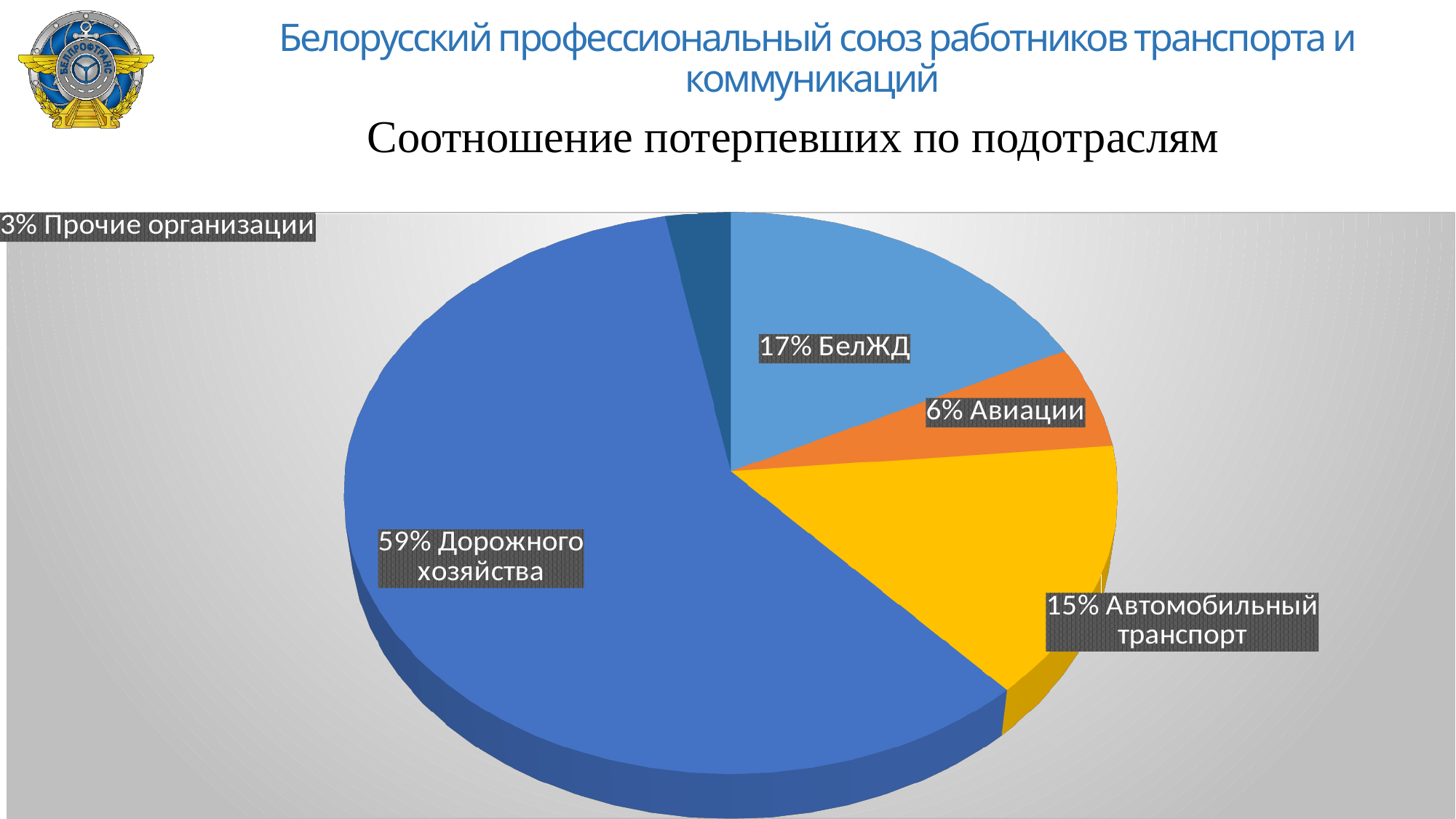
Which has a larger share, Авиации or Прочие организации? Авиации What share of the pie does Прочие организации have? 3% What kind of chart is shown on the slide? Pie chart Which category has the smallest share of the pie? Прочие организации What is the title of the chart? Соотношение потерпевших по подотраслям What share of the pie does БелЖД have? 17% How many slices does the pie chart have? 5 What share of the pie does Дорожного хозяйства have? 59% What is the difference in percentage points between БелЖД and Автомобильный транспорт? 2 Which category has the largest share of the pie? Дорожного хозяйства